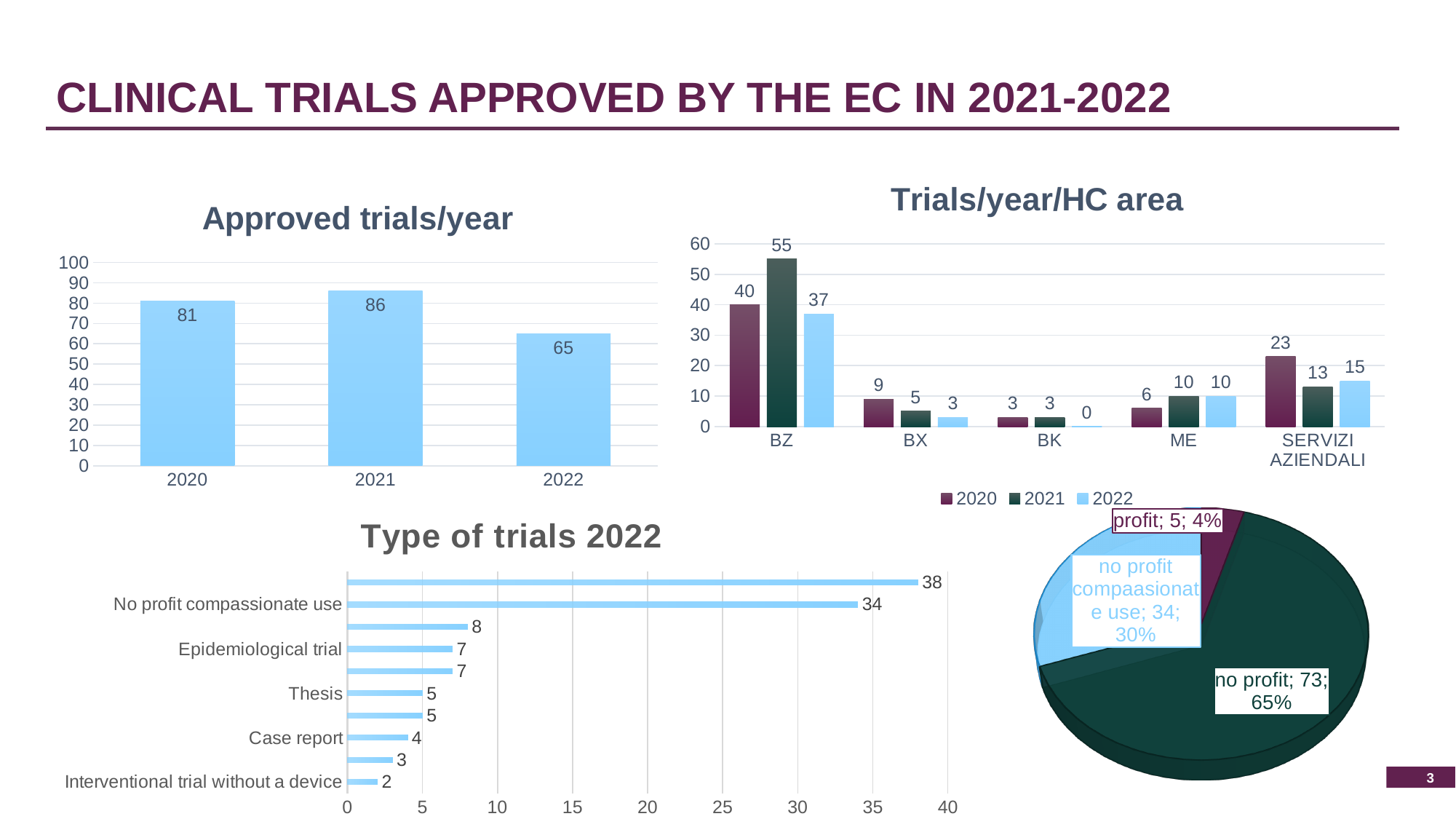
In the 'Trials/year/HC area' chart, what is the value for BZ in 2021? 55 In the 'Trials/year/HC area' chart, is the 2020 value for BX larger or the 2020 value for ME? BX In the 'Trials/year/HC area' chart, which HC area has the highest value in 2022? BZ In the 'Type of trials 2022' chart, what is the value for 'Interventional trial without a device'? 2 What kind of chart is 'Approved trials/year'? bar chart In the 'Approved trials/year' chart, which year has the lowest number of approved trials? 2022 In the 'Trials/year/HC area' chart, what is the value for SERVIZI AZIENDALI in 2020? 23 In the 'Type of trials 2022' chart, what is the value for 'No profit compassionate use'? 34 In the pie chart, what share does the 'no profit' slice represent? 65% How many series does the legend of the 'Trials/year/HC area' chart list? 3 In the 'Approved trials/year' chart, what is the difference between the 2021 and 2022 values? 21 In the 'Approved trials/year' chart, how many trials were approved in 2021? 86